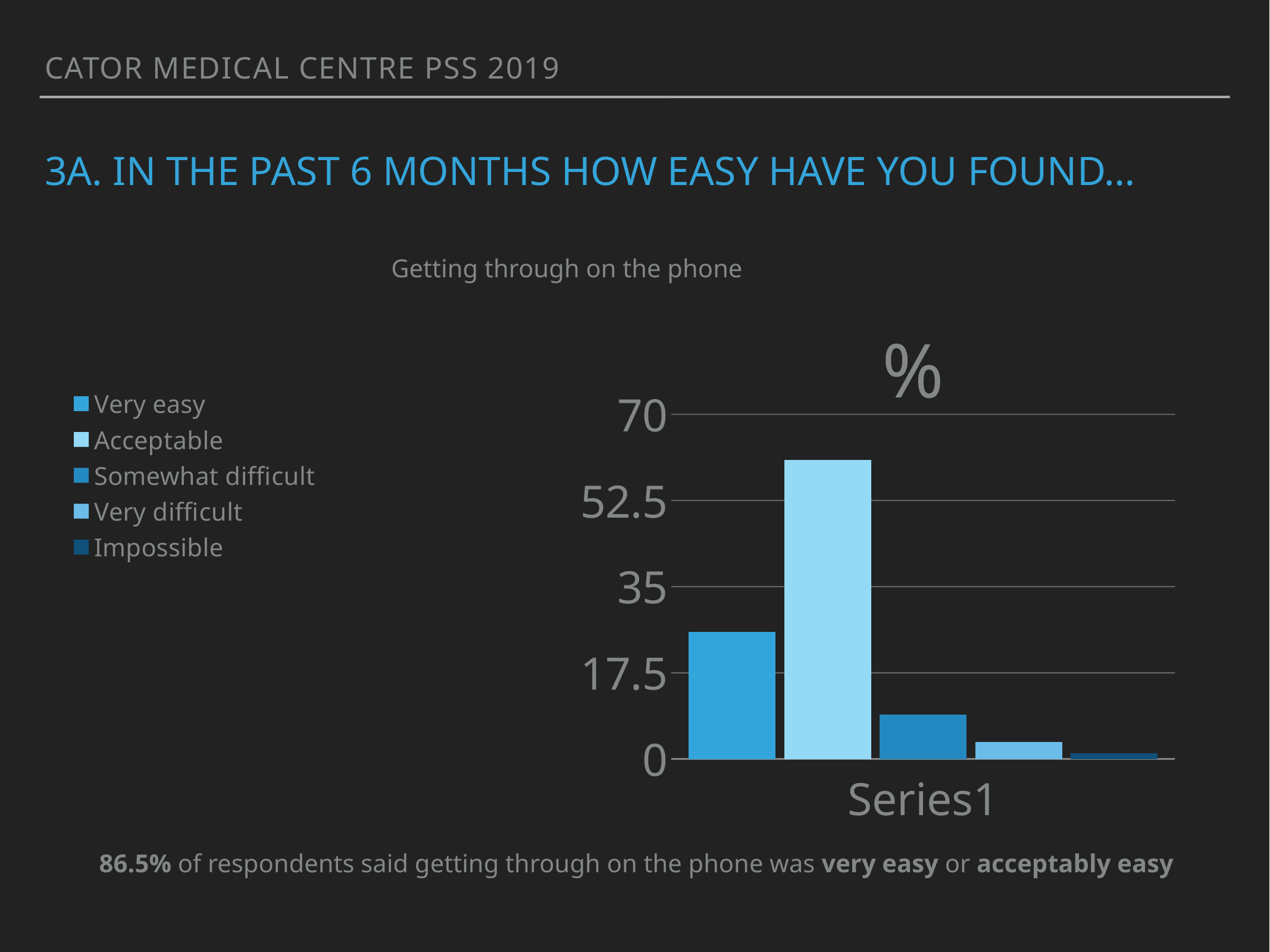
What kind of chart is shown on the slide? bar chart How many entries does the chart legend list? 5 Which category has the highest bar? Acceptable Is the value for Somewhat difficult greater or less than 17.5? less Which category has the lowest bar? Impossible Is the value for Acceptable greater or less than 52.5? greater What is the title of the chart? % How many bars are plotted in the chart? 5 Is the value for Very easy greater or less than 35? less Which is larger, the value for Very easy or the value for Somewhat difficult? Very easy Which is larger, the value for Acceptable or the value for Very easy? Acceptable